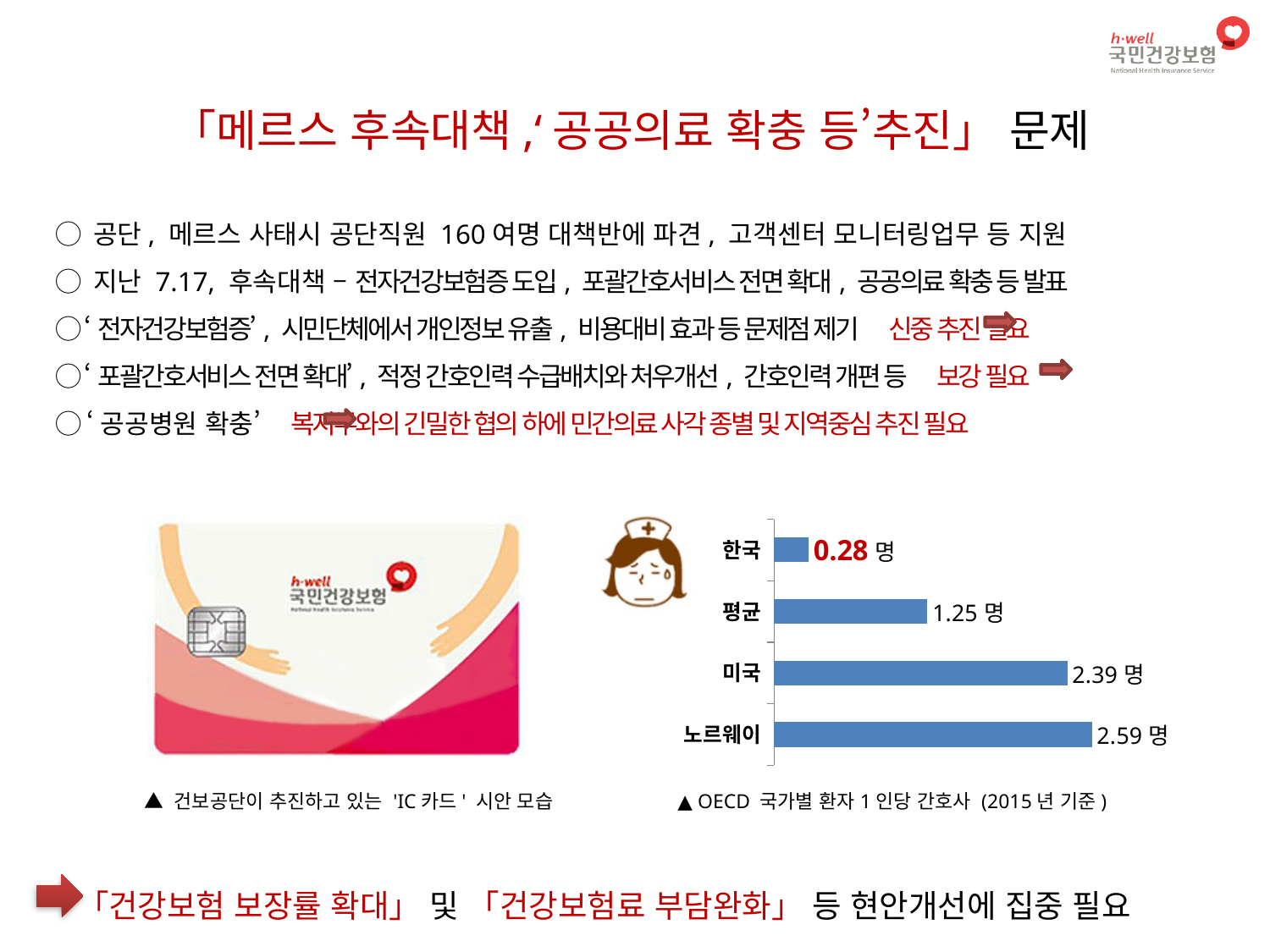
What is the value for 미국 in the bar chart? 2.39 명 What is the value for 한국 in the bar chart? 0.28 명 Which is larger in the bar chart, the value for 미국 or the value for 평균? 미국 What is the value for 노르웨이 in the bar chart? 2.59 명 What is the value for 평균 in the bar chart? 1.25 명 What does the caption below the bar chart say the chart shows? OECD 국가별 환자 1인당 간호사 (2015년 기준) Which category has the lowest value in the bar chart? 한국 What is the difference between the values for 노르웨이 and 한국 in the bar chart? 2.31 명 Which category has the highest value in the bar chart? 노르웨이 What kind of chart is shown on the slide? Bar chart How many categories are shown in the bar chart? 4 What is the difference between the values for 미국 and 평균 in the bar chart? 1.14 명